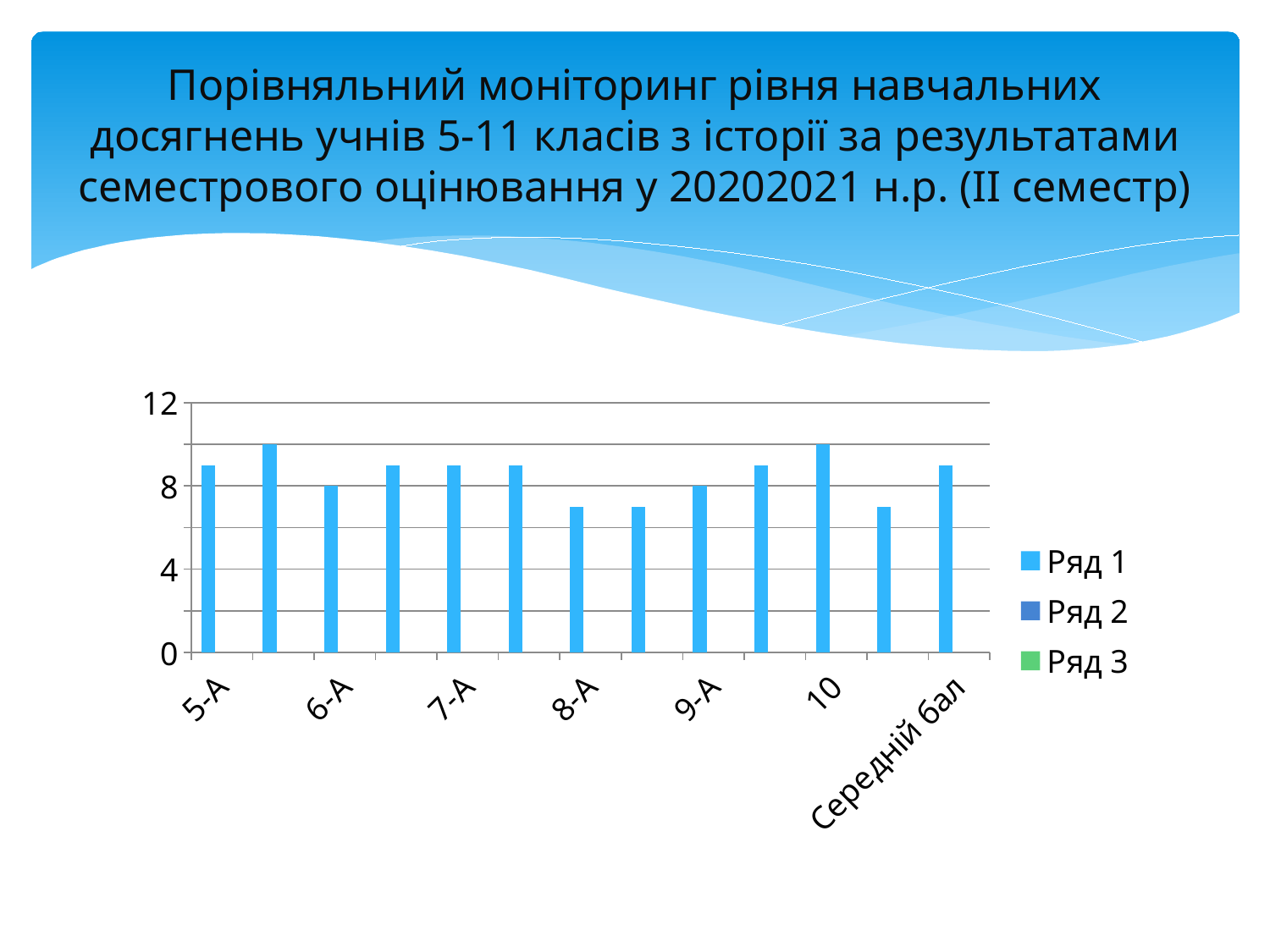
Is the value for 5-А greater or less than 8? greater Which is larger, the value for 10 or the value for 8-А? 10 Is the value for Середній бал greater or less than 8? greater How many series does the legend list? 3 Is the value for 10 greater or less than 8? greater What is the highest value shown on the vertical axis? 12 What is the value for 9-А? 8 What is the value for 6-А? 8 What are the entries listed in the legend? Ряд 1, Ряд 2, Ряд 3 What kind of chart is shown on the slide? bar chart How many bars are plotted in the chart? 13